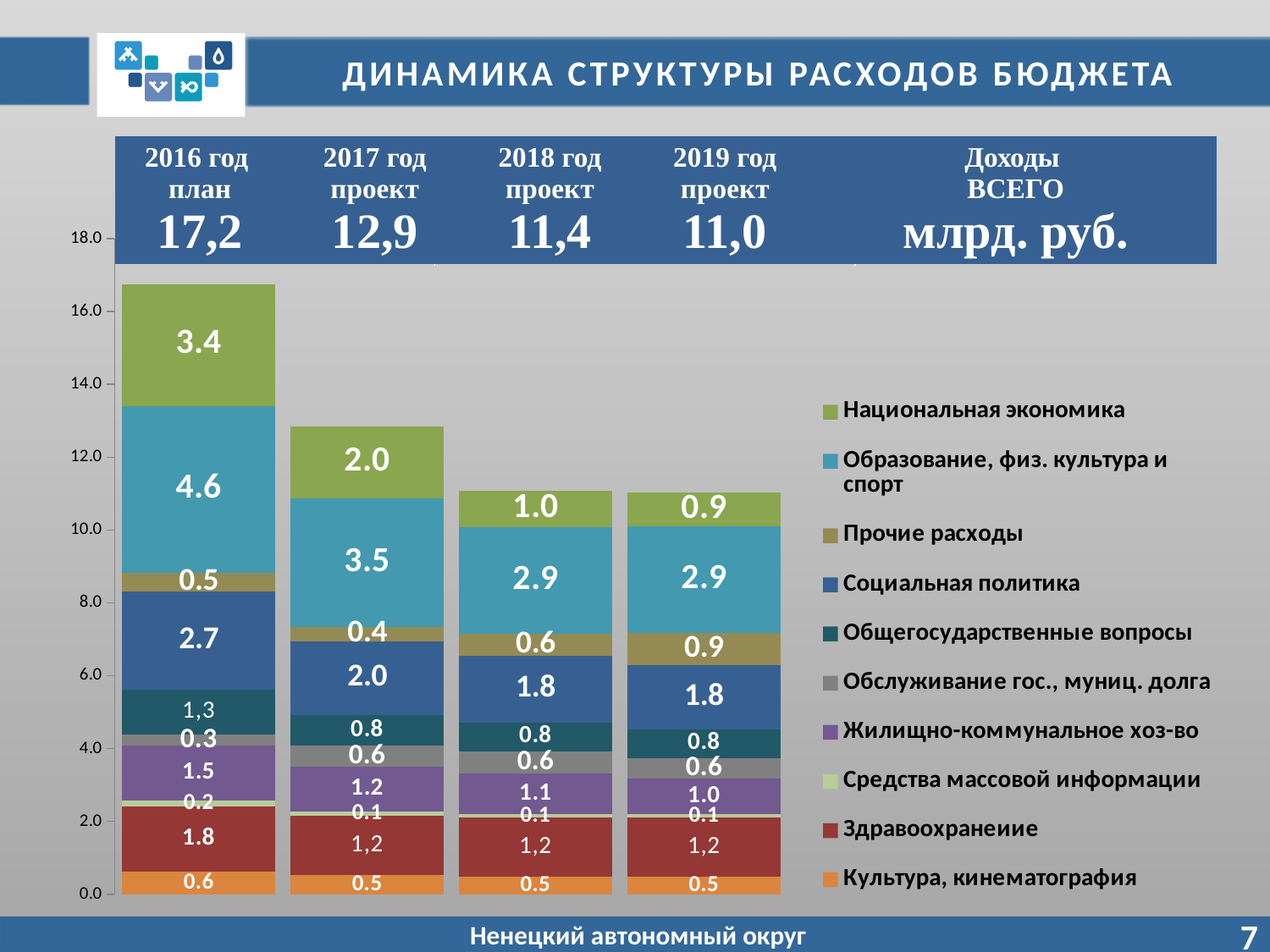
How many series does the legend list? 10 What kind of chart is shown on the slide? stacked bar chart Is the top of the 2016 год план stacked bar greater or less than 16.0? greater What is the value for Социальная политика in the 2018 год проект bar? 1.8 What is the difference between the Образование, физ. культура и спорт values for 2016 год план and 2019 год проект? 1.7 Which is larger, the Социальная политика value for 2016 год план or for 2017 год проект? 2016 год план What is the value for Образование, физ. культура и спорт in the 2017 год проект bar? 3.5 How many stacked bars are shown in the chart? 4 What is the value for Национальная экономика in the 2016 год план bar? 3.4 In which year is the value for Национальная экономика the lowest? 2019 год проект In which year is the value for Национальная экономика the highest? 2016 год план What is the value for Здравоохранение in the 2019 год проект bar? 1,2